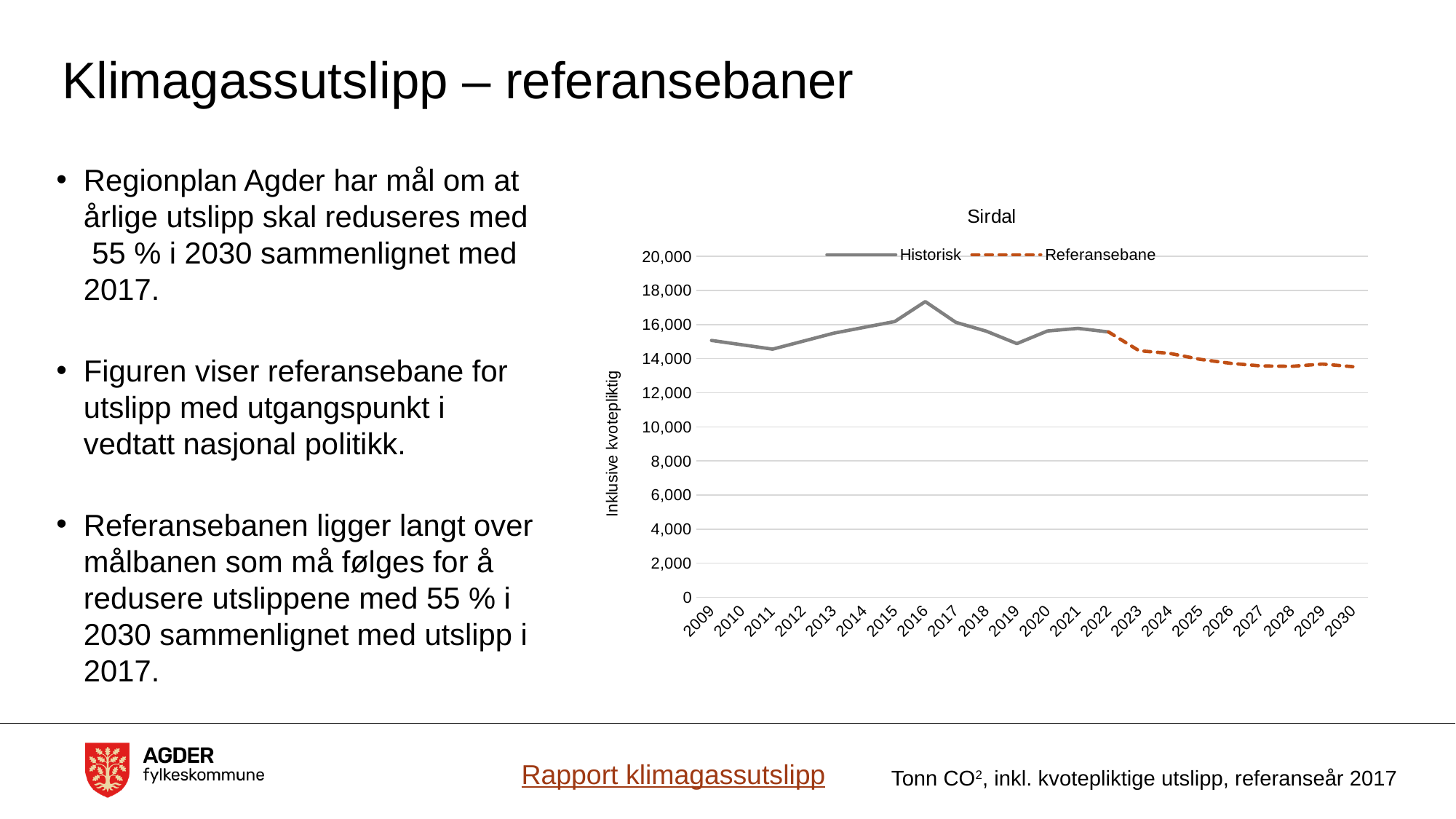
What kind of chart is shown on the slide? line chart How many series does the chart legend list? 2 In which year does the Historisk series reach its highest value? 2016 What is the title of the chart? Sirdal Does the Referansebane series rise or fall from 2022 to 2030? fall Is the Referansebane value for 2030 greater or less than 14,000? less What are the two series named in the chart legend? Historisk and Referansebane Does the Historisk series rise or fall from 2016 to 2019? fall Is the Historisk value for 2019 greater or less than 16,000? less Is the Historisk value for 2016 greater or less than 16,000? greater How many years are shown along the x axis of the chart? 22 Which year has the larger Historisk value, 2016 or 2019? 2016